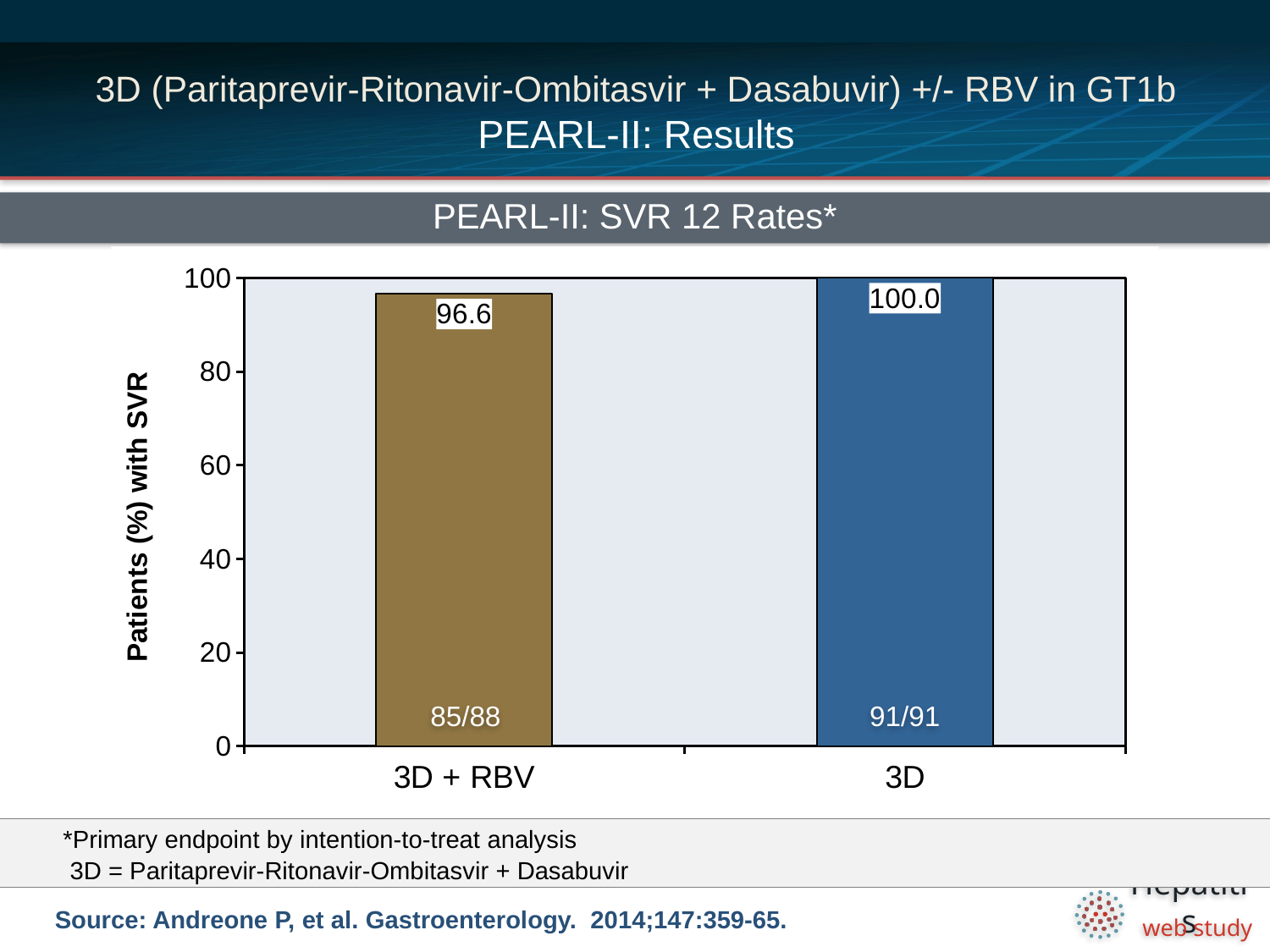
What is the SVR 12 rate for the 3D + RBV group? 96.6 Which treatment group has the lower SVR 12 rate? 3D + RBV How many patients achieved SVR out of the total in the 3D group? 91/91 Which treatment group has the higher SVR 12 rate? 3D What is the label of the y-axis? Patients (%) with SVR How many treatment groups are shown in the chart? 2 What is the SVR 12 rate for the 3D group? 100.0 How many patients achieved SVR out of the total in the 3D + RBV group? 85/88 What is the title of the chart? PEARL-II: SVR 12 Rates* What kind of chart is shown on the slide? bar chart Is the SVR 12 rate for 3D + RBV greater or less than 80? greater What is the difference in SVR 12 rate between the 3D group and the 3D + RBV group? 3.4